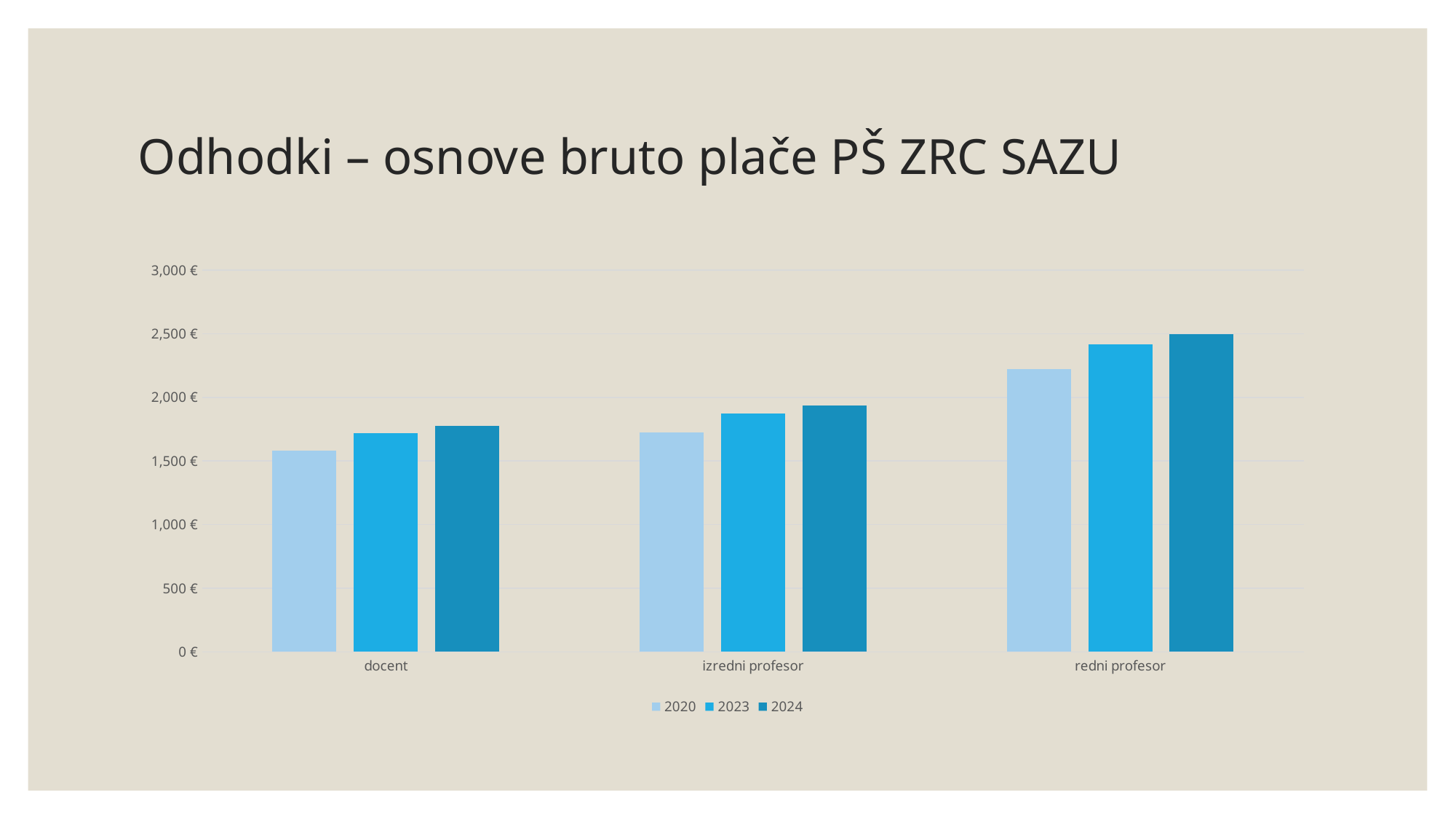
What is the title of the chart on the slide? Odhodki – osnove bruto plače PŠ ZRC SAZU How many categories are shown on the x axis? 3 Do the values for each category rise or fall from 2020 to 2024? rise What kind of chart is shown on the slide? bar chart Is the value for docent in 2020 greater or less than 1,500 €? greater Is the value for redni profesor in 2020 greater or less than 2,000 €? greater Is the value for docent in 2024 greater or less than 2,000 €? less Which category has the highest bar for 2024? redni profesor How many series does the legend list? 3 Which is larger: the 2020 value for redni profesor or the 2024 value for izredni profesor? the 2020 value for redni profesor Which category has the lowest bar for 2020? docent